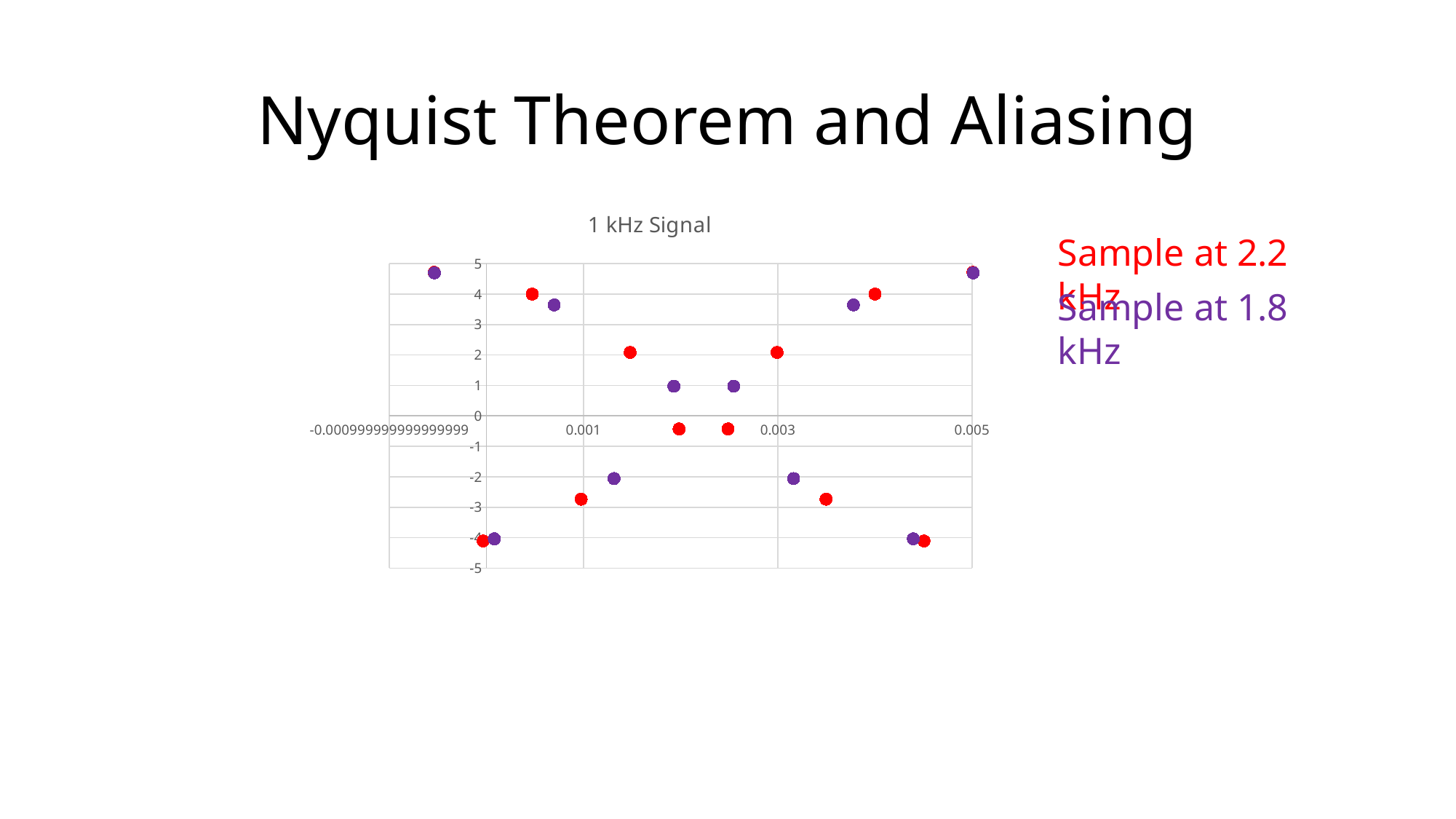
Are the two purple points closest to x = 0.002 greater or less than 0? greater Which colour of points reaches the highest value on the chart, red or purple? purple Are the two red points closest to x = 0.002 greater or less than 0? less Is the red point near x = 0.001 greater or less than -2? less According to the slide text, which sampling rate do the red points represent? 2.2 kHz What is the highest value shown on the vertical axis? 5 How many different colours of points are plotted on the chart? 2 How many red points are plotted on the chart? 10 What is the title of the chart? 1 kHz Signal What kind of chart is shown on the slide? scatter chart